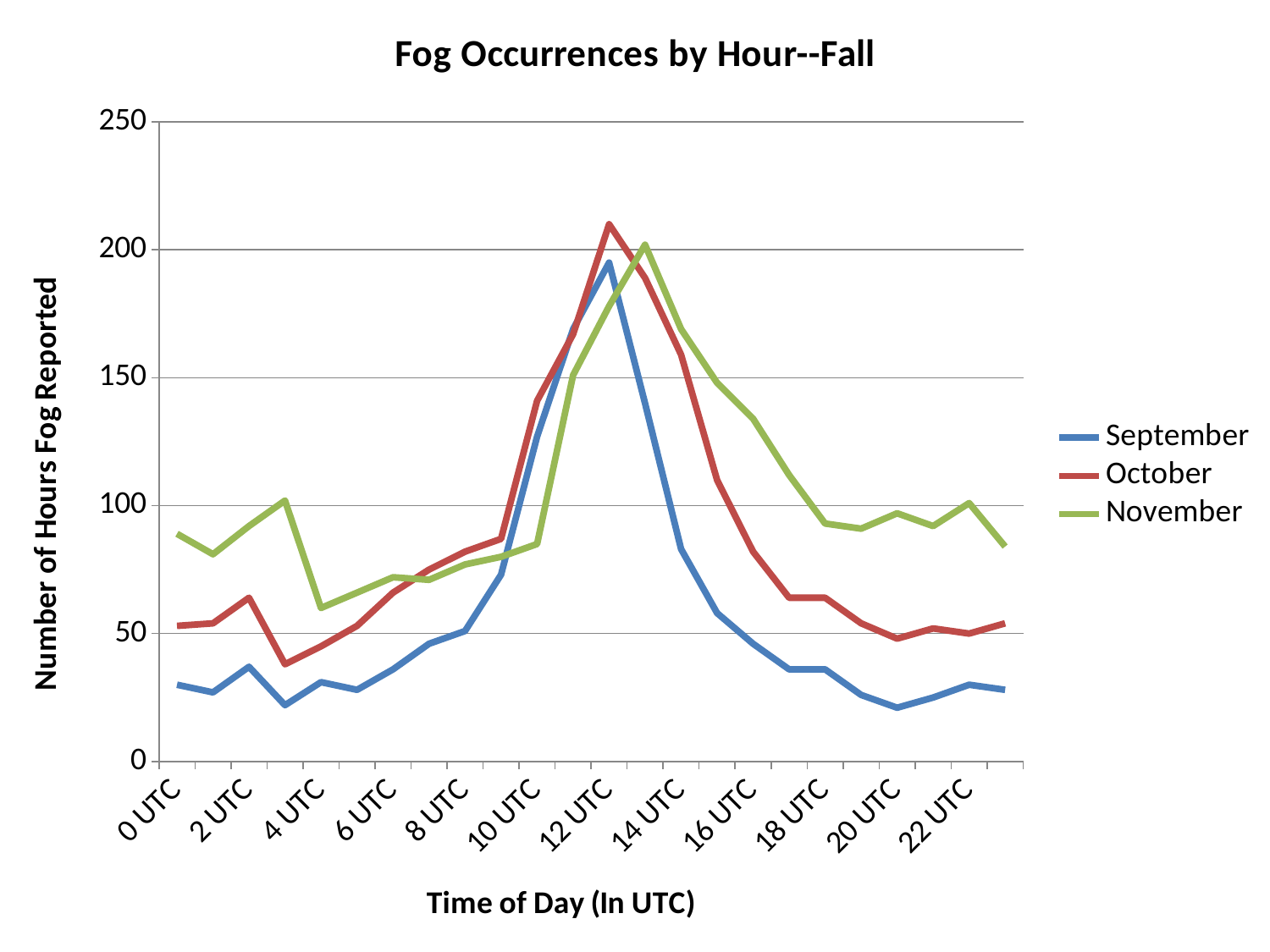
At 18 UTC, which series has the higher value, November or September? November Is the value for September at 20 UTC greater or less than 50? less What kind of chart is shown on the slide? Line chart What is the title of the chart? Fog Occurrences by Hour--Fall Which series has the lowest value at 20 UTC? September Is the value for November at 4 UTC greater or less than 100? less Is the value for September at 12 UTC greater or less than 150? greater What is the label of the vertical axis? Number of Hours Fog Reported How many series does the legend list? 3 Does the September line rise or fall between 12 UTC and 20 UTC? Fall